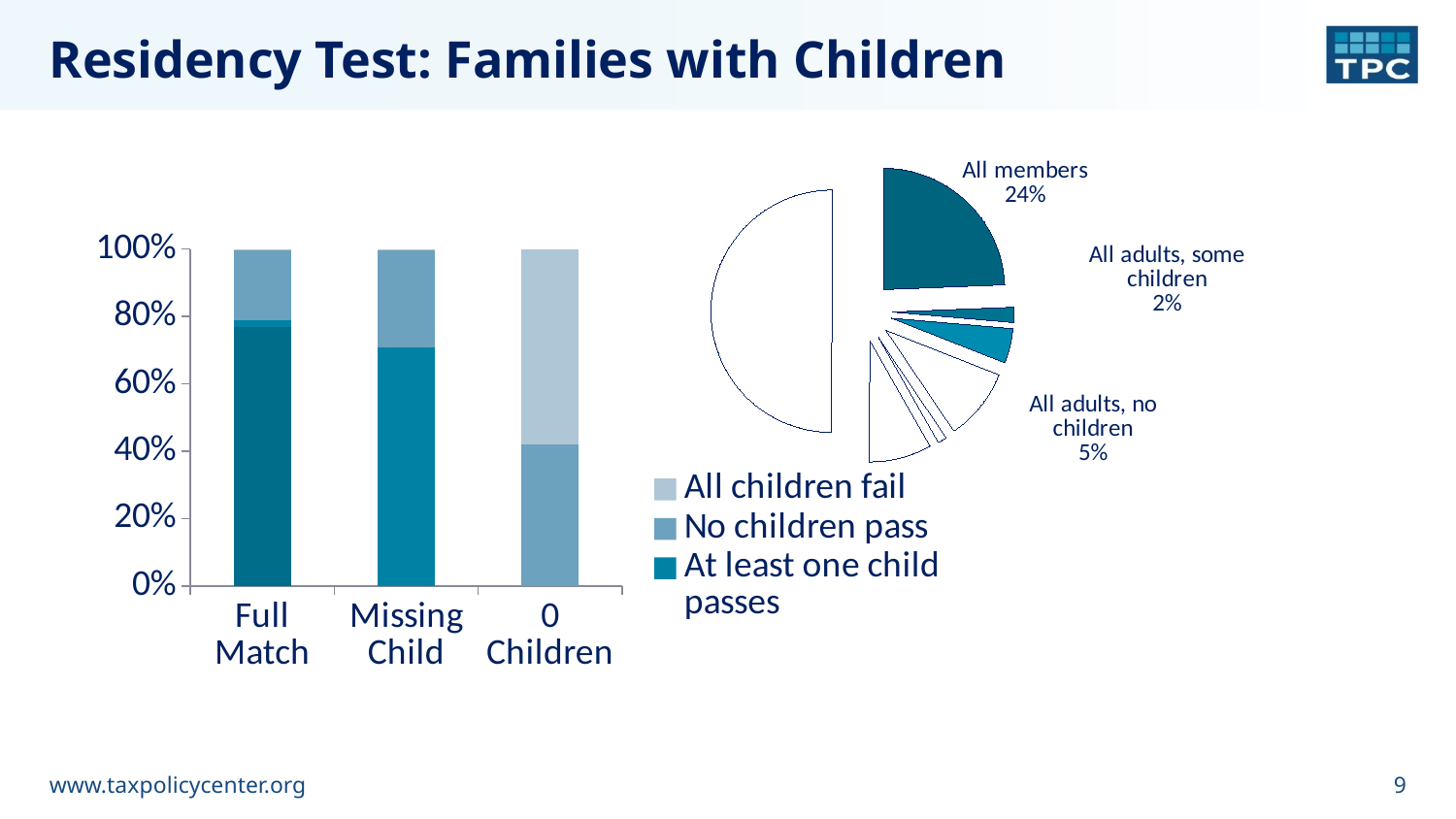
What kind of chart is the chart on the right of the slide? pie chart What kind of chart is the chart on the left of the slide? bar chart In the bar chart on the left, is the value of 'No children pass' for 0 Children greater or less than 60%? less In the pie chart on the right, what share is labelled for 'All adults, some children'? 2% In the bar chart on the left, how many categories are shown on the x axis? 3 In the pie chart on the right, what share is labelled for 'All adults, no children'? 5% In the pie chart on the right, what is the difference between the 'All members' share and the 'All adults, no children' share? 19% In the bar chart on the left, how many series does the legend list? 3 In the pie chart on the right, which is larger: 'All members' or 'All adults, no children'? All members In the bar chart on the left, is the value of 'At least one child passes' for Full Match greater or less than 60%? less In the bar chart on the left, is the value of 'At least one child passes' for Missing Child greater or less than 60%? greater In the pie chart on the right, what share is labelled for 'All members'? 24%